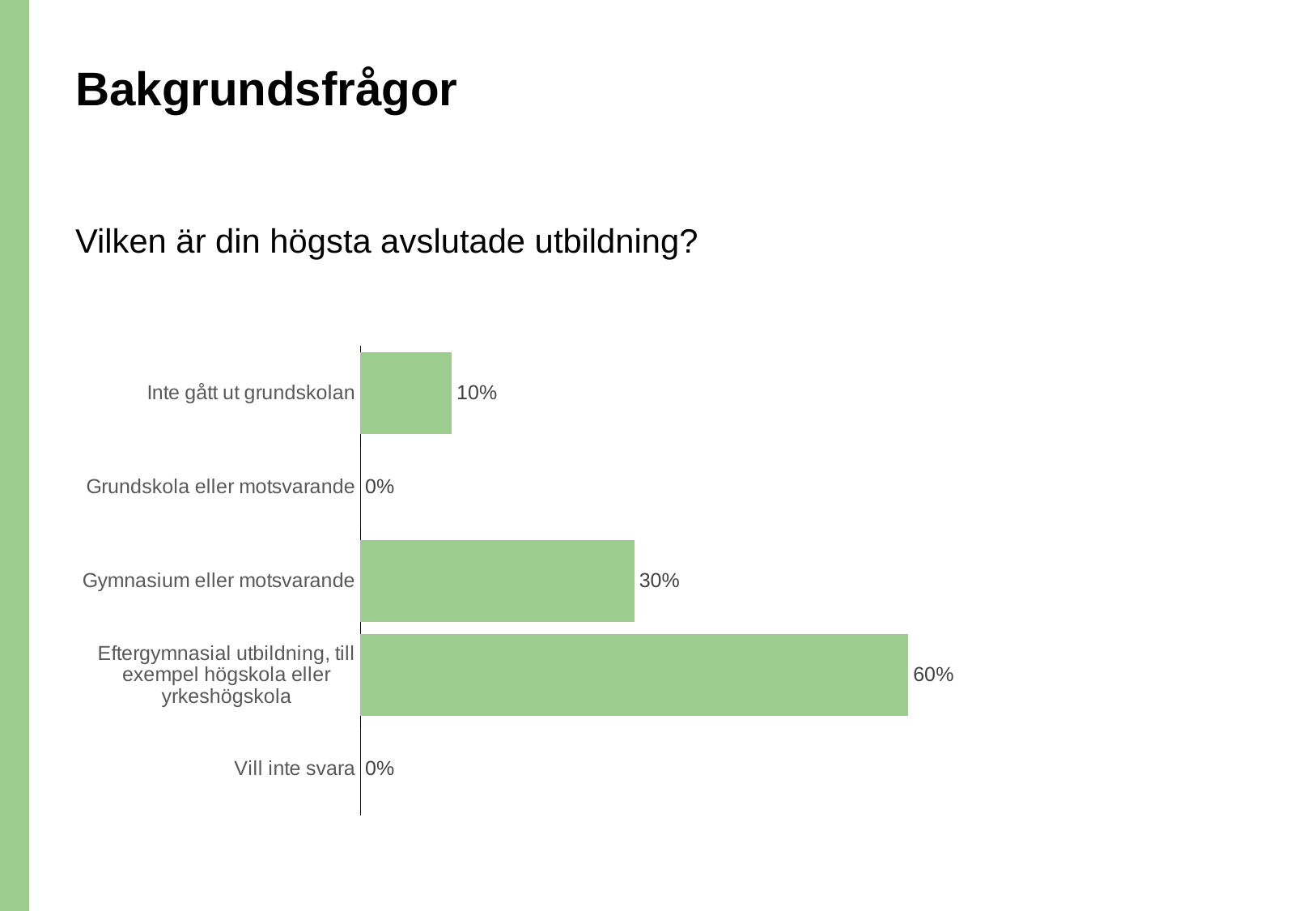
What is the value for "Vill inte svara"? 0% What is the difference between the values for "Eftergymnasial utbildning, till exempel högskola eller yrkeshögskola" and "Gymnasium eller motsvarande"? 30% What is the value for "Eftergymnasial utbildning, till exempel högskola eller yrkeshögskola"? 60% What is the difference between the values for "Gymnasium eller motsvarande" and "Inte gått ut grundskolan"? 20% Which category has the highest value? Eftergymnasial utbildning, till exempel högskola eller yrkeshögskola What kind of chart is shown on the slide? Bar chart What is the value for "Inte gått ut grundskolan"? 10% How many categories are shown in the chart? 5 How many categories have a value of 0%? 2 Which is larger, the value for "Gymnasium eller motsvarande" or the value for "Inte gått ut grundskolan"? Gymnasium eller motsvarande What is the value for "Gymnasium eller motsvarande"? 30% What question does the chart on the slide answer? Vilken är din högsta avslutade utbildning?